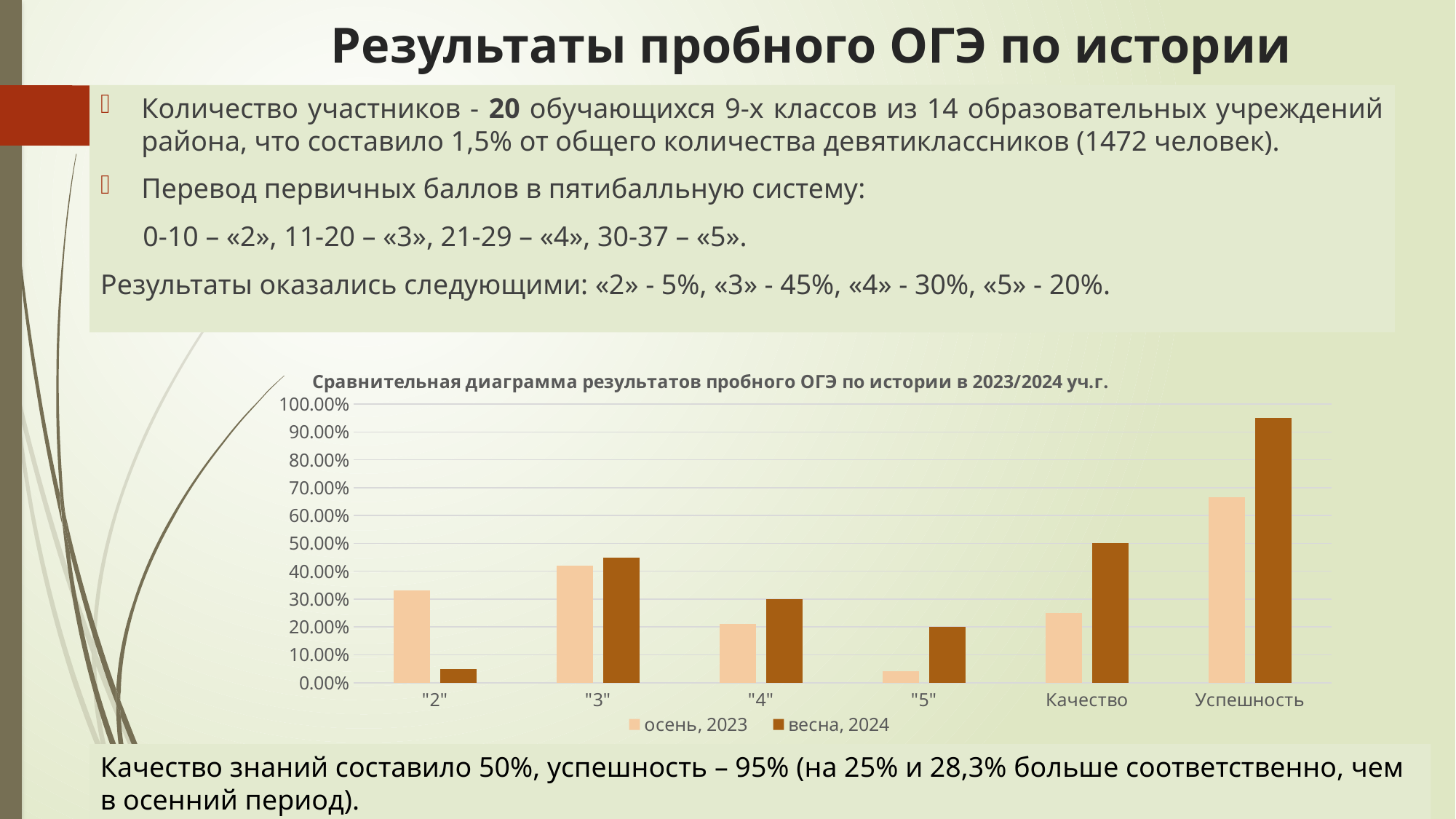
Which category has the lowest value in the весна, 2024 series? "2" Which category has the highest bar in the chart? Успешность (весна, 2024) How many series does the chart legend list? 2 For category "4", which series has the larger value: осень, 2023 or весна, 2024? весна, 2024 For category "2", which series has the larger value: осень, 2023 or весна, 2024? осень, 2023 What are the two series named in the chart legend? осень, 2023 and весна, 2024 What is the value for "4" in the весна, 2024 series? 30% What is the value for Успешность in the весна, 2024 series? 95% What is the value for Качество in the весна, 2024 series? 50% How many categories are shown along the x axis of the chart? 6 What kind of chart is shown on the slide? bar chart Is the value for Успешность in the осень, 2023 series greater or less than 60.00%? greater